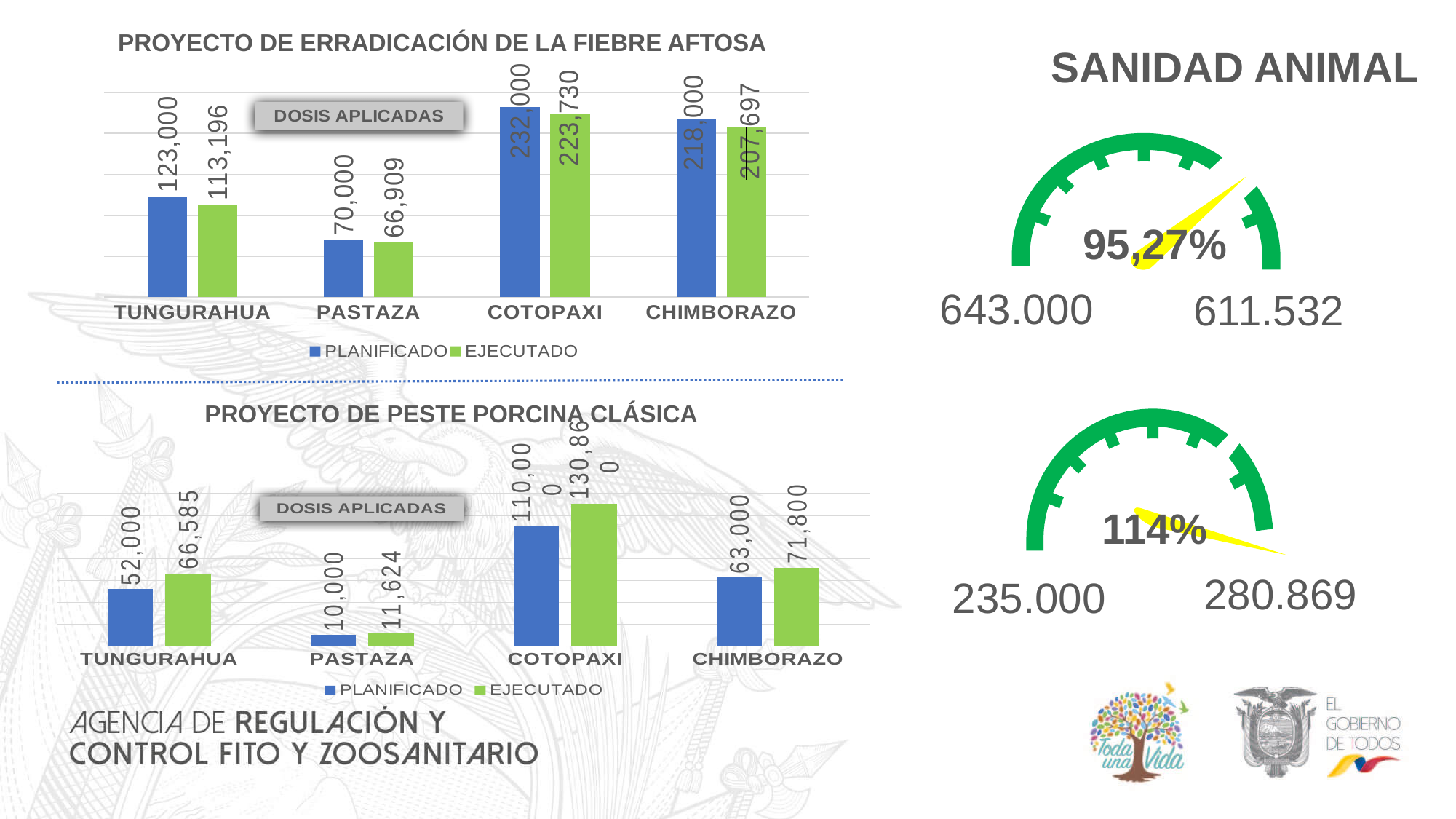
In the PROYECTO DE PESTE PORCINA CLÁSICA chart, what is the difference between EJECUTADO and PLANIFICADO for CHIMBORAZO? 8,800 What type of chart is the PROYECTO DE PESTE PORCINA CLÁSICA chart? Bar chart In the PROYECTO DE ERRADICACIÓN DE LA FIEBRE AFTOSA chart, what is the PLANIFICADO value for TUNGURAHUA? 123,000 In the PROYECTO DE PESTE PORCINA CLÁSICA chart, what is the EJECUTADO value for TUNGURAHUA? 66,585 How many provinces are shown on the x axis of the PROYECTO DE PESTE PORCINA CLÁSICA chart? 4 In the PROYECTO DE PESTE PORCINA CLÁSICA chart, which province has the highest PLANIFICADO value? COTOPAXI How many series does the legend of the PROYECTO DE ERRADICACIÓN DE LA FIEBRE AFTOSA chart list? 2 In the PROYECTO DE ERRADICACIÓN DE LA FIEBRE AFTOSA chart, what is the difference between PLANIFICADO and EJECUTADO for CHIMBORAZO? 10,303 In the PROYECTO DE ERRADICACIÓN DE LA FIEBRE AFTOSA chart, which is larger for PASTAZA, PLANIFICADO or EJECUTADO? PLANIFICADO In the PROYECTO DE ERRADICACIÓN DE LA FIEBRE AFTOSA chart, which province has the lowest EJECUTADO value? PASTAZA In the PROYECTO DE PESTE PORCINA CLÁSICA chart, what is the PLANIFICADO value for PASTAZA? 10,000 In the PROYECTO DE ERRADICACIÓN DE LA FIEBRE AFTOSA chart, what is the EJECUTADO value for COTOPAXI? 223,730